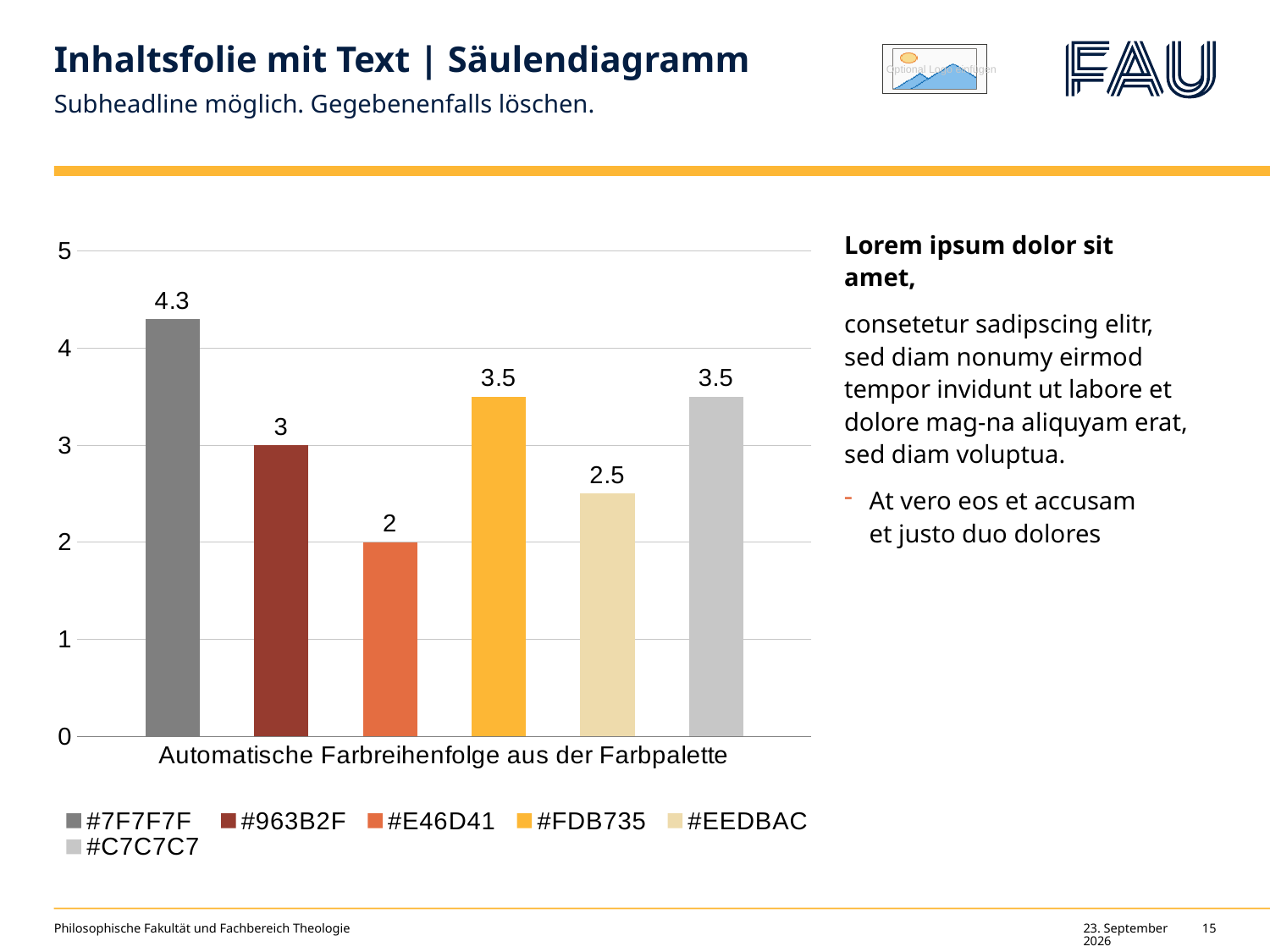
What is the value of the #E46D41 series? 2 What is the value of the #7F7F7F series? 4.3 How many series does the legend list? 6 Which series has the lowest value? #E46D41 What is the difference between the values of #7F7F7F and #963B2F? 1.3 What kind of chart is shown on the slide? bar chart Is the value for #C7C7C7 greater or less than 3? greater What is the value of the #EEDBAC series? 2.5 Which series has the highest value? #7F7F7F Which is larger, the value of #FDB735 or the value of #EEDBAC? #FDB735 What is the value of the #963B2F series? 3 How many bars are plotted in the chart? 6